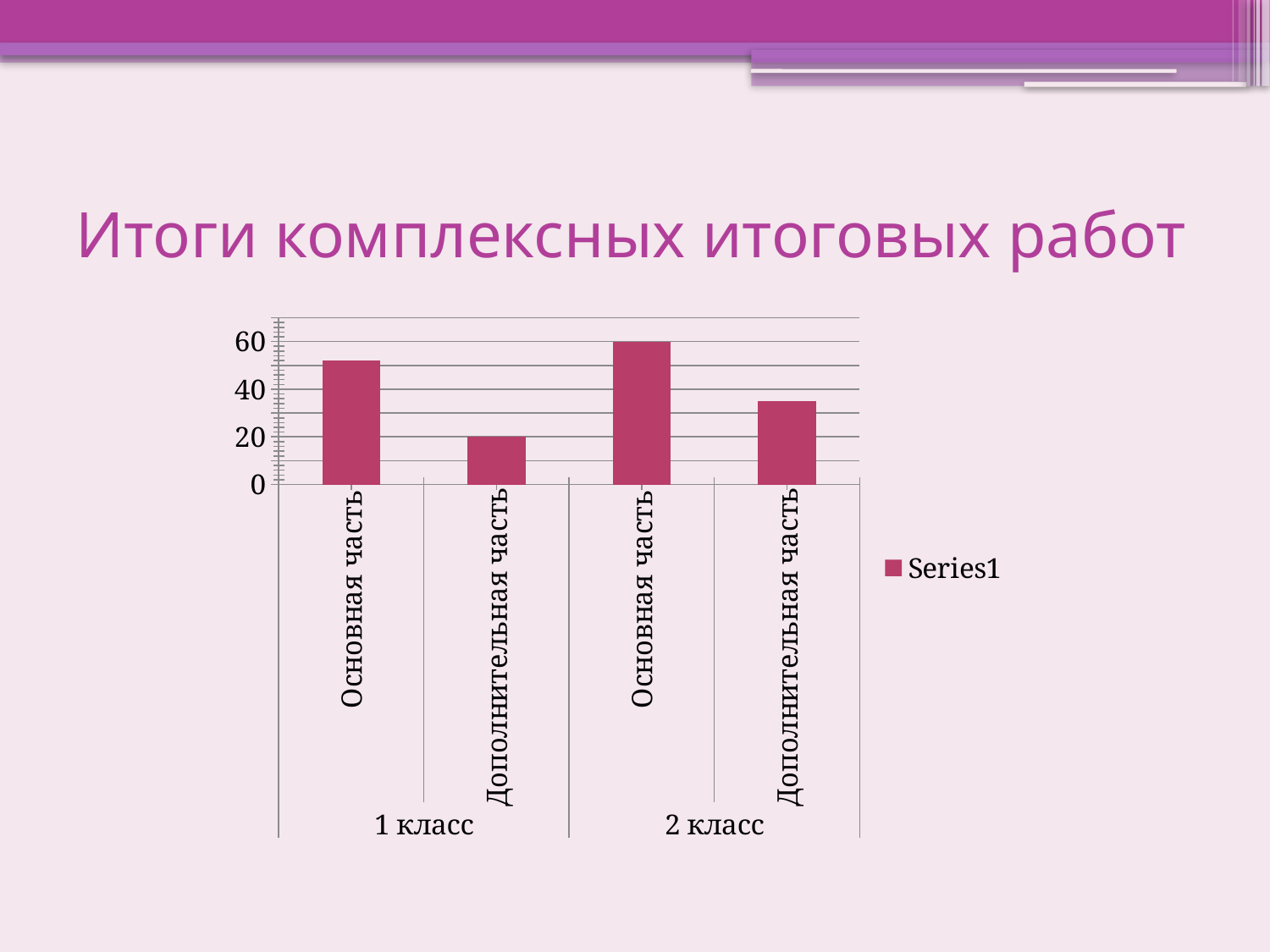
Which bar has the highest value? Основная часть, 2 класс What is the title of the slide? Итоги комплексных итоговых работ What kind of chart is shown on the slide? bar chart Which bar has the lowest value? Дополнительная часть, 1 класс What is the name of the series shown in the legend? Series1 How many bars are plotted in the chart? 4 Is the value for Дополнительная часть in 2 класс greater or less than 40? less What is the value for Дополнительная часть in 1 класс? 20 How many series does the legend list? 1 Is the value for Основная часть in 1 класс greater or less than 40? greater What is the value for Основная часть in 2 класс? 60 Which is larger: Основная часть in 1 класс or Основная часть in 2 класс? Основная часть in 2 класс